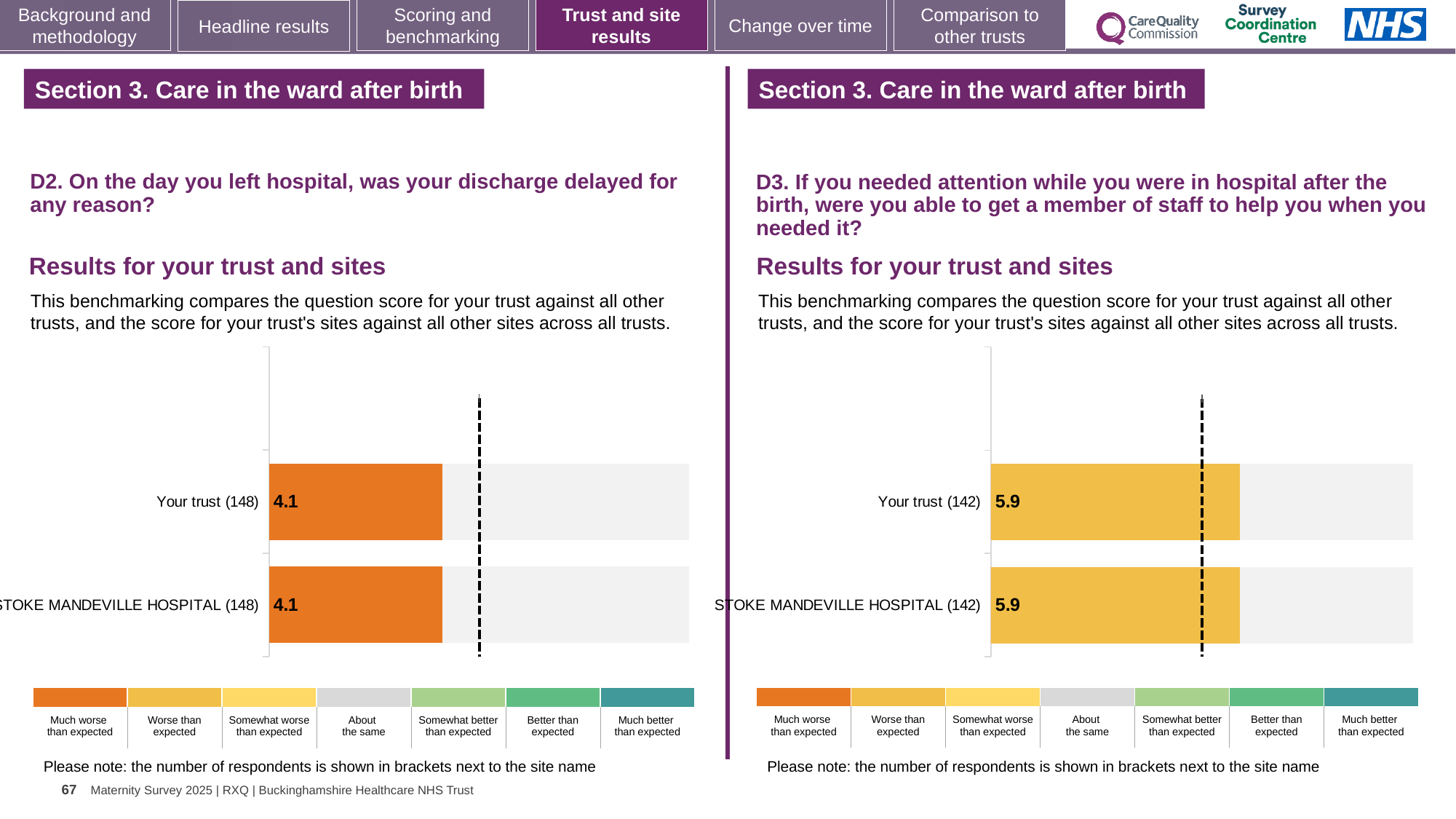
On the right chart (D3), what is the score for STOKE MANDEVILLE HOSPITAL? 5.9 What kind of chart is used on the left (D2)? Bar chart On the left chart (D2), what is the score for Your trust? 4.1 On the right chart (D3), how many respondents are shown in brackets for STOKE MANDEVILLE HOSPITAL? 142 How many bars are plotted on the right chart (D3)? 2 On the left chart (D2), how many respondents are shown in brackets for Your trust? 148 On the left chart (D2), what is the score for STOKE MANDEVILLE HOSPITAL? 4.1 On the right chart (D3), what is the score for Your trust? 5.9 How many bars are plotted on the left chart (D2)? 2 On the right chart (D3), which benchmark category does the colour of the bars correspond to according to the legend? Worse than expected On the right chart (D3), what is the difference between the score for Your trust and the score for STOKE MANDEVILLE HOSPITAL? 0 On the left chart (D2), what is the difference between the score for Your trust and the score for STOKE MANDEVILLE HOSPITAL? 0